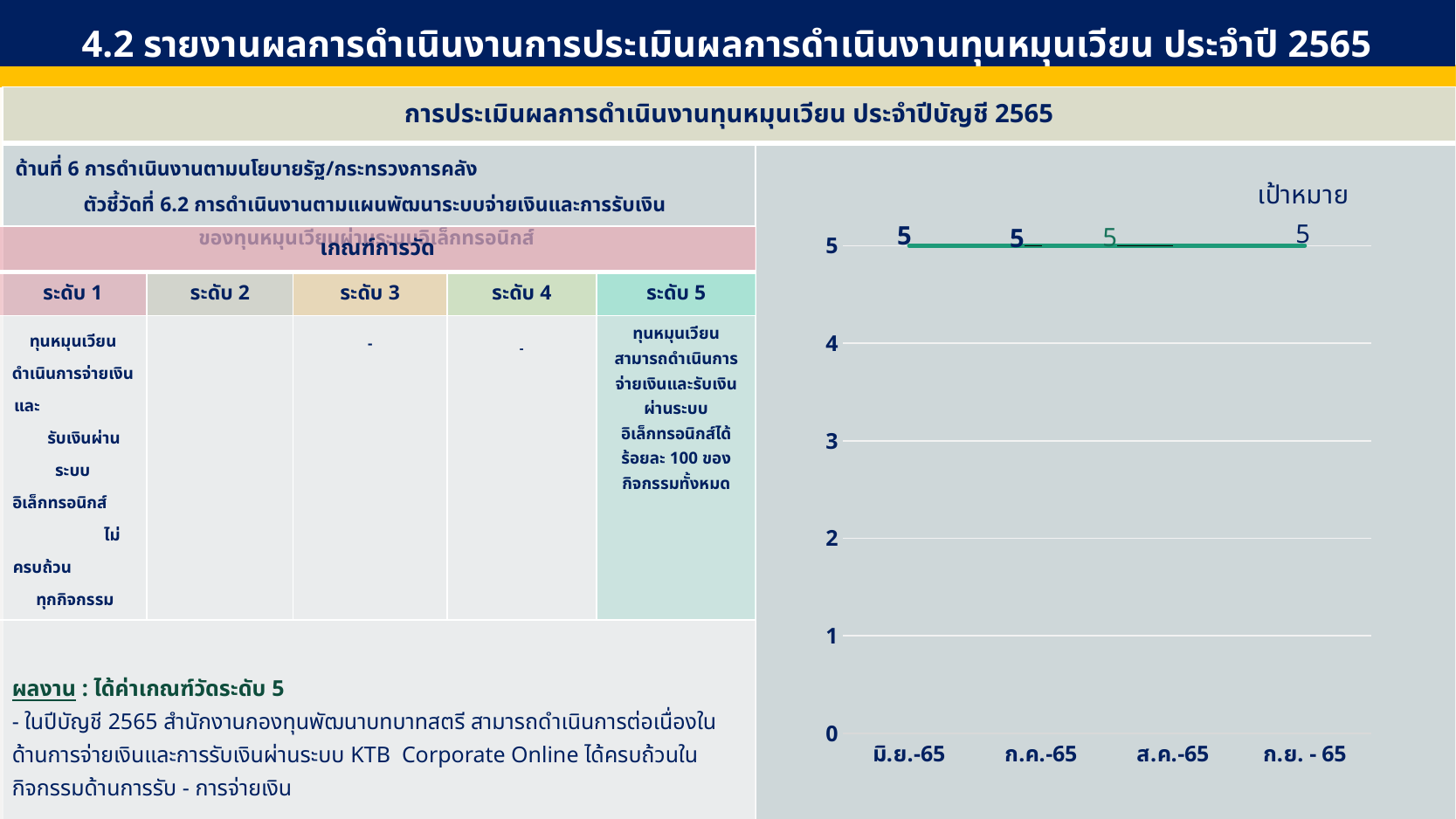
What is the value for ก.ค.-65 in the chart? 5 What is the value for ส.ค.-65 in the chart? 5 Do the values rise, fall, or stay flat from มิ.ย.-65 to ก.ย. - 65? stay flat What is the value for มิ.ย.-65 in the chart? 5 What is the value for ก.ย. - 65 in the chart? 5 What is the difference between the values for มิ.ย.-65 and ก.ย. - 65? 0 What type of chart is shown on the right side of the slide? line chart Is the value for ส.ค.-65 greater or less than 4? greater How many categories are shown on the x axis of the chart? 4 What is the highest value shown on the y axis of the chart? 5 What label is shown above the line in the chart? เป้าหมาย